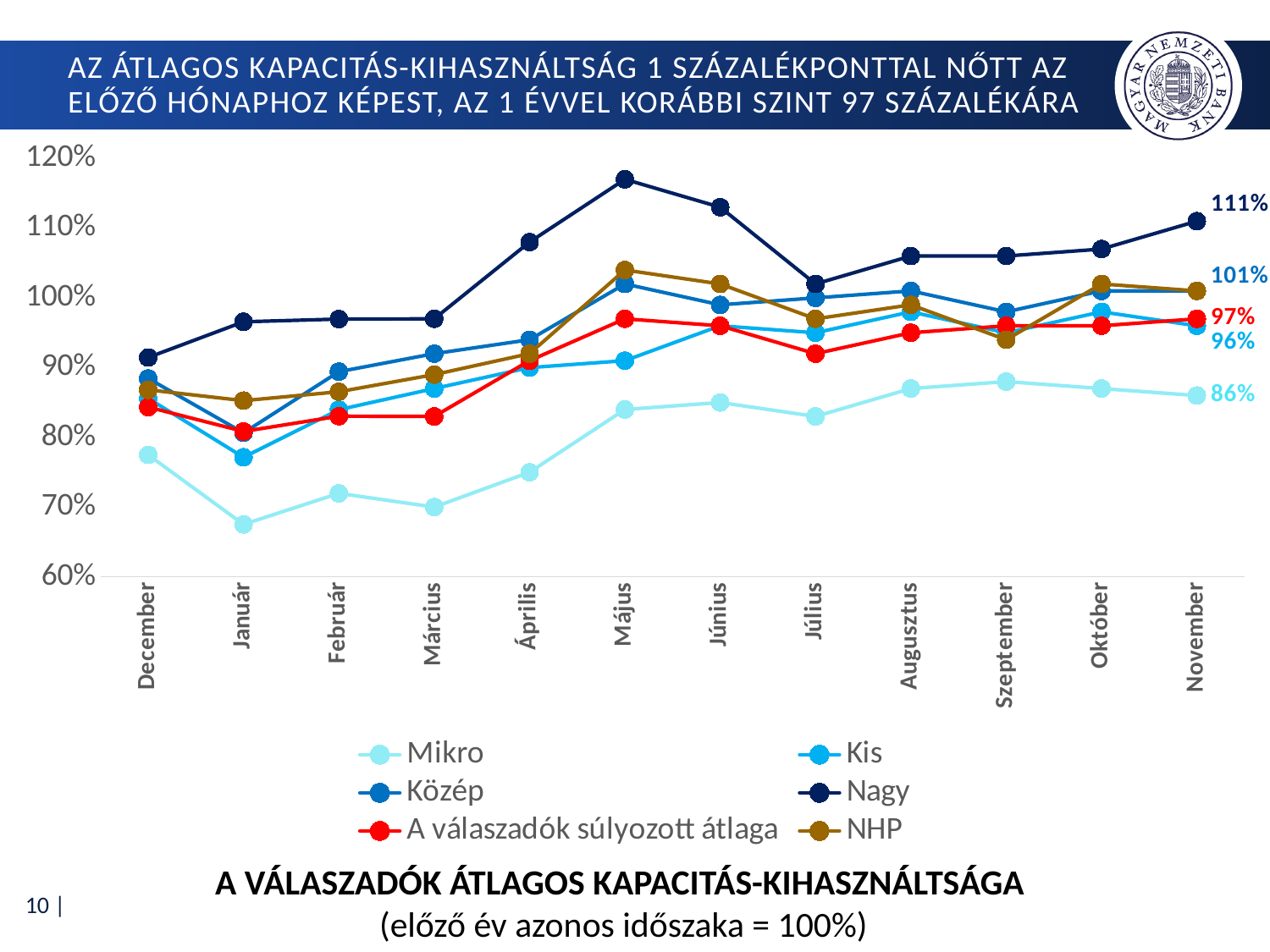
In which month does the Nagy series reach its highest value? Május Which series has the highest value in November? Nagy In which month is the Mikro series at its lowest? Január How many months are shown on the x axis? 12 What is the value of the Kis series in November? 96% What is the value of the Mikro series in November? 86% Is the value of the Mikro series in Január greater or less than 70%? less What is the difference between the Nagy and Mikro values in November? 25 percentage points How many series does the legend list? 6 What is the value of the Nagy series in November? 111% Is the value of the Nagy series in Május greater or less than 110%? greater What is the value of 'A válaszadók súlyozott átlaga' in November? 97%